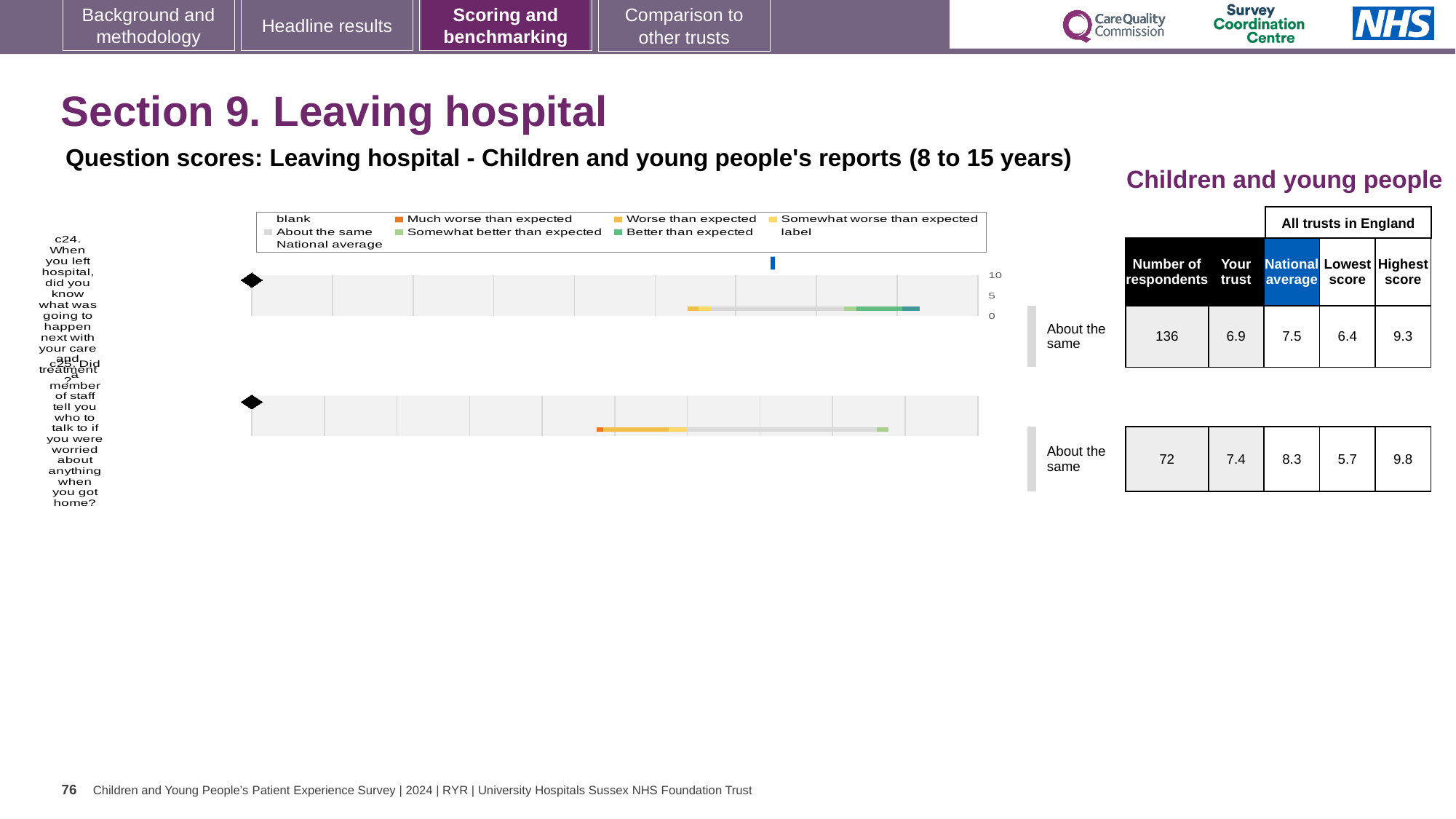
In the legend of the Leaving hospital chart, what colour represents 'Much worse than expected'? orange How many entries does the legend of the Leaving hospital chart list? 9 What kind of chart is used to show the question scores for Leaving hospital? bar chart How many questions (bars) are plotted in the Leaving hospital chart? 2 How many respondents answered question c24? 136 What is the national average score for question c25 (did a member of staff tell you who to talk to if you were worried)? 8.3 What is the difference between the national average (7.5) and the trust score (6.9) for question c24? 0.6 What is the 'Your trust' score for question c24 (did you know what was going to happen next with your care and treatment)? 6.9 Which question has the lower 'Lowest score' across all trusts in England, c24 or c25? c25 Which question has the higher 'Your trust' score, c24 or c25? c25 What benchmark category is shown for question c24? About the same What is the highest score among all trusts in England for question c25? 9.8